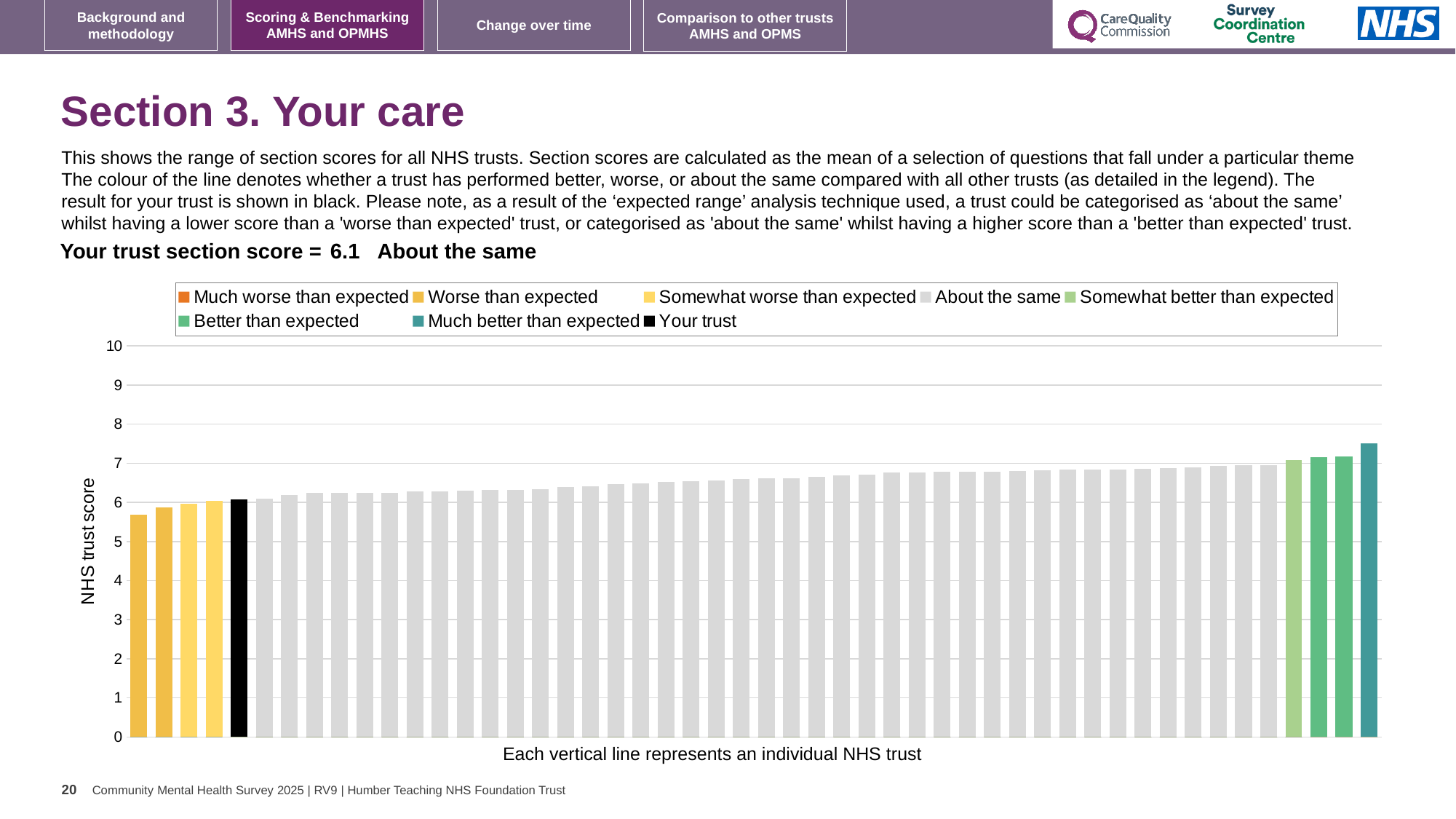
What is the label on the vertical axis of the chart? NHS trust score Do the bar values rise or fall from left to right across the chart? rise Which legend category does the highest bar belong to? Much better than expected Is the value of the black bar (your trust) greater or less than 5? greater Is the value of the leftmost bar greater or less than 6? less How many entries does the chart legend list? 8 Is the value of the tallest bar greater or less than 7? greater Which performance category is your trust placed in for Section 3? About the same What is the section score for your trust shown on the slide? 6.1 What kind of chart is shown on the slide? bar chart